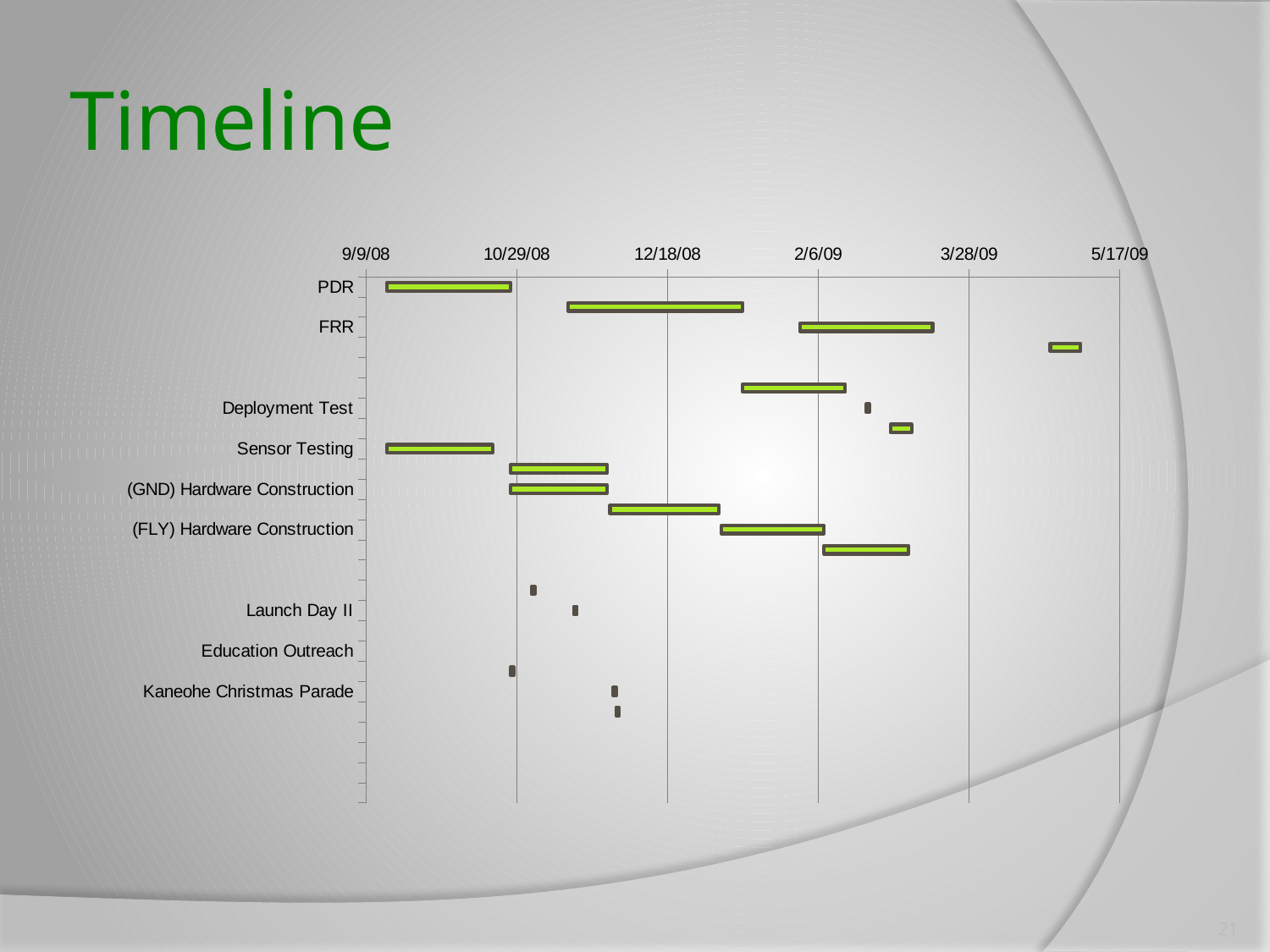
What is the earliest date shown on the chart's date axis? 9/9/08 Which occurs earlier on the timeline, the PDR bar or the FRR bar? PDR Does the Sensor Testing bar end before or after 10/29/08? before How many labelled task categories are listed on the vertical axis of the chart? 9 What is the latest date shown on the chart's date axis? 5/17/09 What is the title of the slide containing the chart? Timeline What kind of chart is shown on the slide? Bar chart Which occurs later on the timeline, the (FLY) Hardware Construction bar or the (GND) Hardware Construction bar? (FLY) Hardware Construction Does the Deployment Test marker fall before or after 2/6/09? after Does the Launch Day II marker fall before or after 12/18/08? before How many date labels are shown along the top axis of the chart? 6